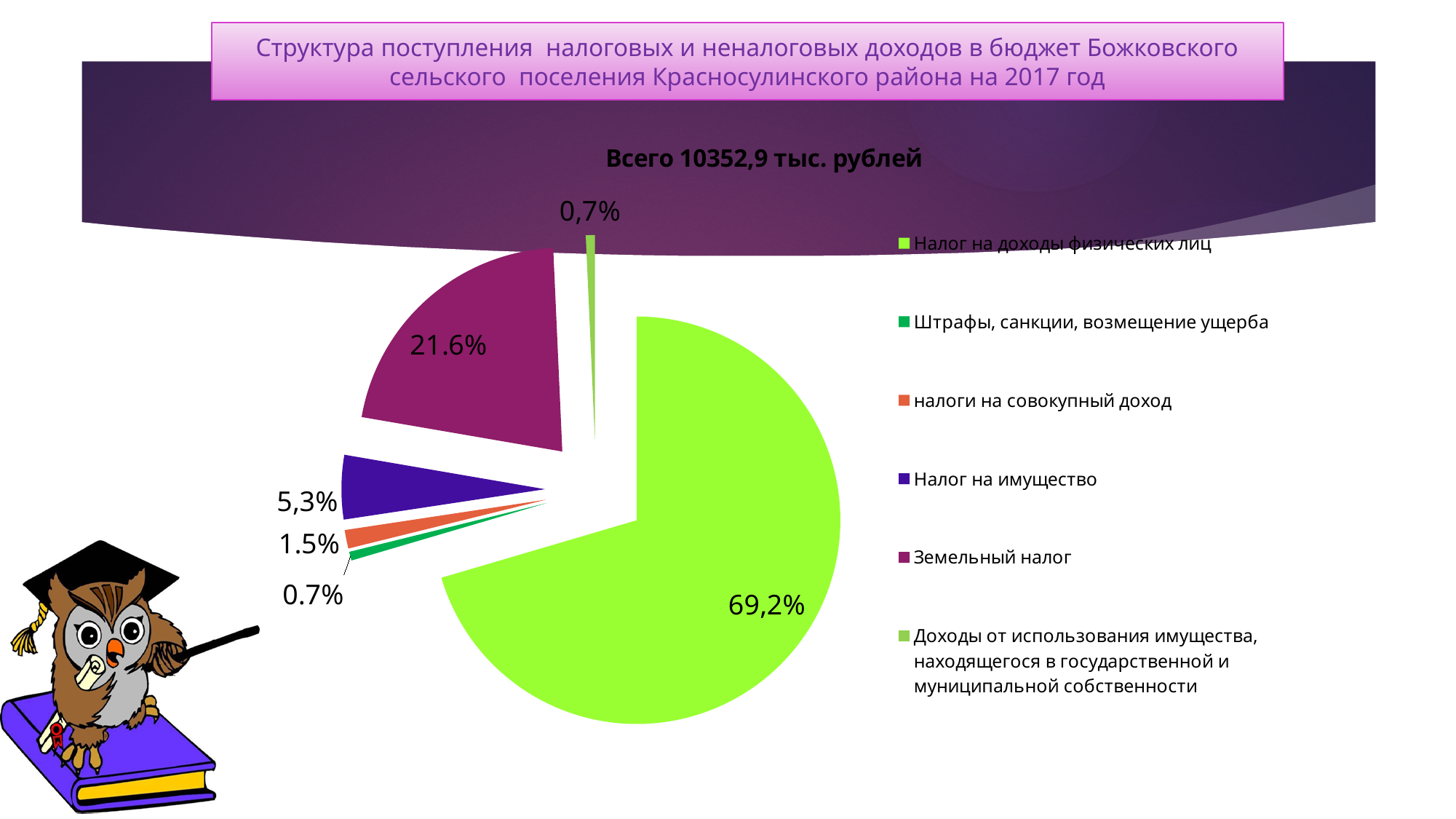
Which category has the largest slice of the pie? Налог на доходы физических лиц What is the difference between the shares of "Налог на доходы физических лиц" and "Земельный налог"? 47.6% How many entries does the legend list? 6 What kind of chart is shown on the slide? pie chart What share of the pie does "Налог на доходы физических лиц" have? 69,2% What share of the pie does "Земельный налог" have? 21.6% Which is larger: the slice for "Земельный налог" or the slice for "Налог на имущество"? Земельный налог What is the value shown for "Штрафы, санкции, возмещение ущерба"? 0.7% What is the value shown for "Налог на имущество"? 5,3% What is the value shown for "налоги на совокупный доход"? 1.5% What is the title printed above the pie chart? Всего 10352,9 тыс. рублей How many slices does the pie chart have? 6